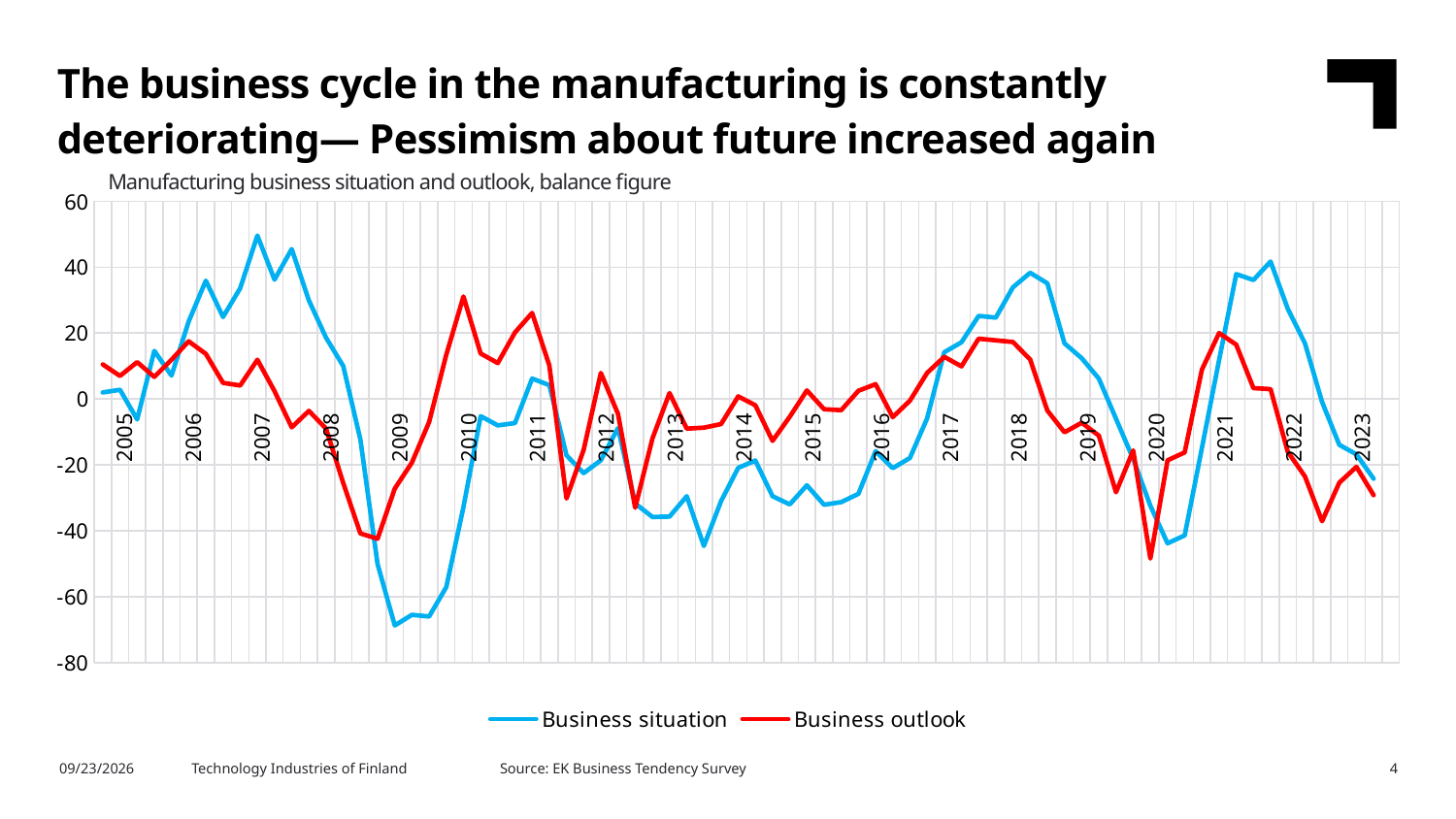
Does the Business situation series rise or fall from its 2021 peak to 2023? Fall Is the highest value of the Business situation series (around 2007) greater or less than 40? greater What are the two series named in the legend? Business situation and Business outlook What is the subtitle of the chart? Manufacturing business situation and outlook, balance figure Around 2009, which series reaches the lower value, Business situation or Business outlook? Business situation How many series does the legend list? 2 Around 2007, which series reaches the higher value, Business situation or Business outlook? Business situation Is the highest value of the Business outlook series (around 2010) greater or less than 20? greater Is the lowest value of the Business outlook series (around 2020) greater or less than -40? less How many year labels are shown on the x axis? 19 What kind of chart is shown on the slide? Line chart